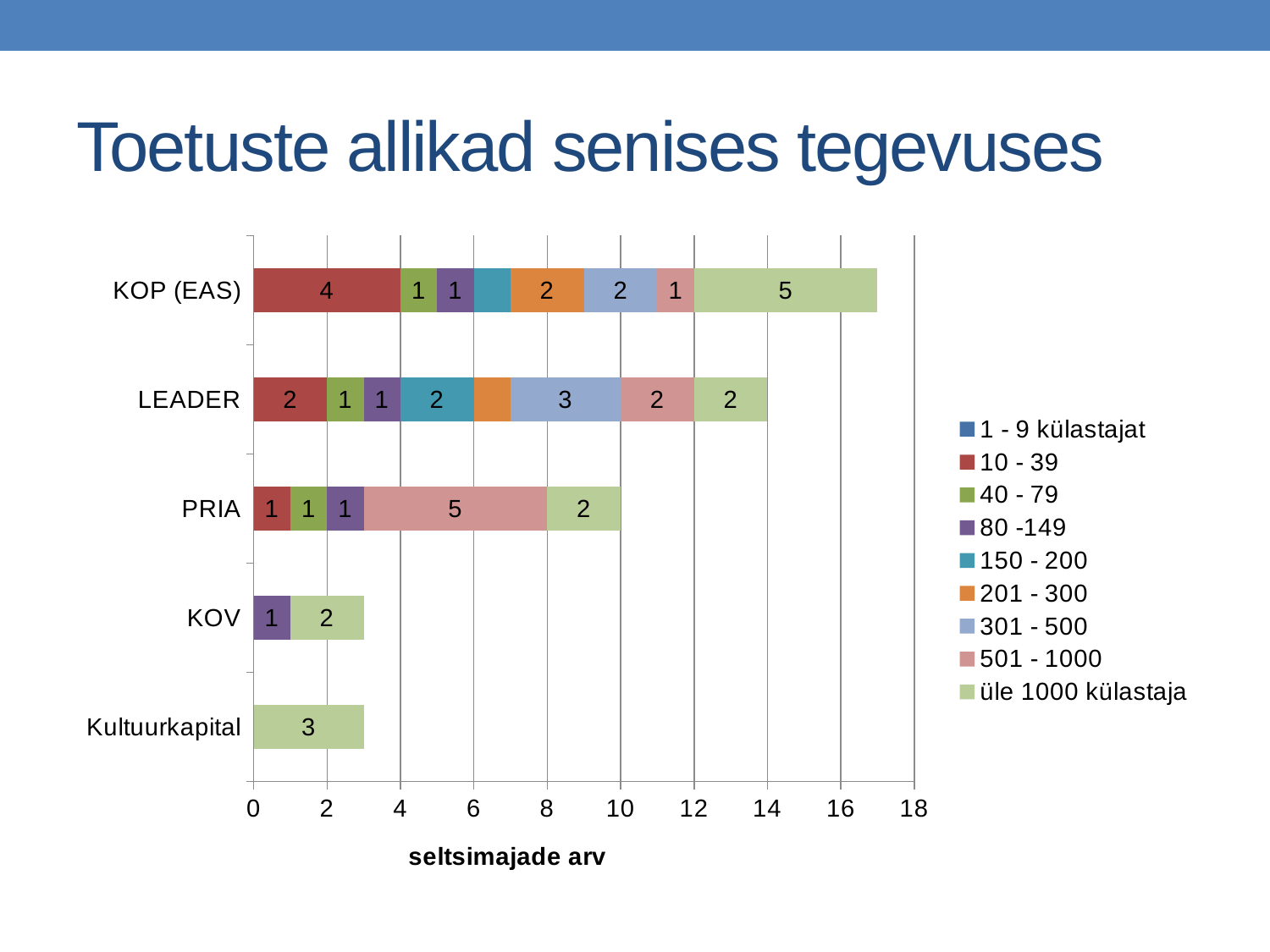
Which is larger, the '10 - 39' segment for KOP (EAS) or for LEADER? KOP (EAS) What is the value of the 'üle 1000 külastaja' segment for Kultuurkapital? 3 What is the value of the '501 - 1000' segment for PRIA? 5 What is the total of the stacked bar for PRIA? 10 What is the value of the 'üle 1000 külastaja' segment for KOP (EAS)? 5 What is the total of the stacked bar for KOV? 3 What is the difference between the 'üle 1000 külastaja' segments of KOP (EAS) and LEADER? 3 How many funding sources (categories) are shown on the y axis? 5 What type of chart is shown on the slide? stacked bar chart What is the value of the '301 - 500' segment for LEADER? 3 How many series does the legend list? 9 Which funding source has the longest total bar? KOP (EAS)